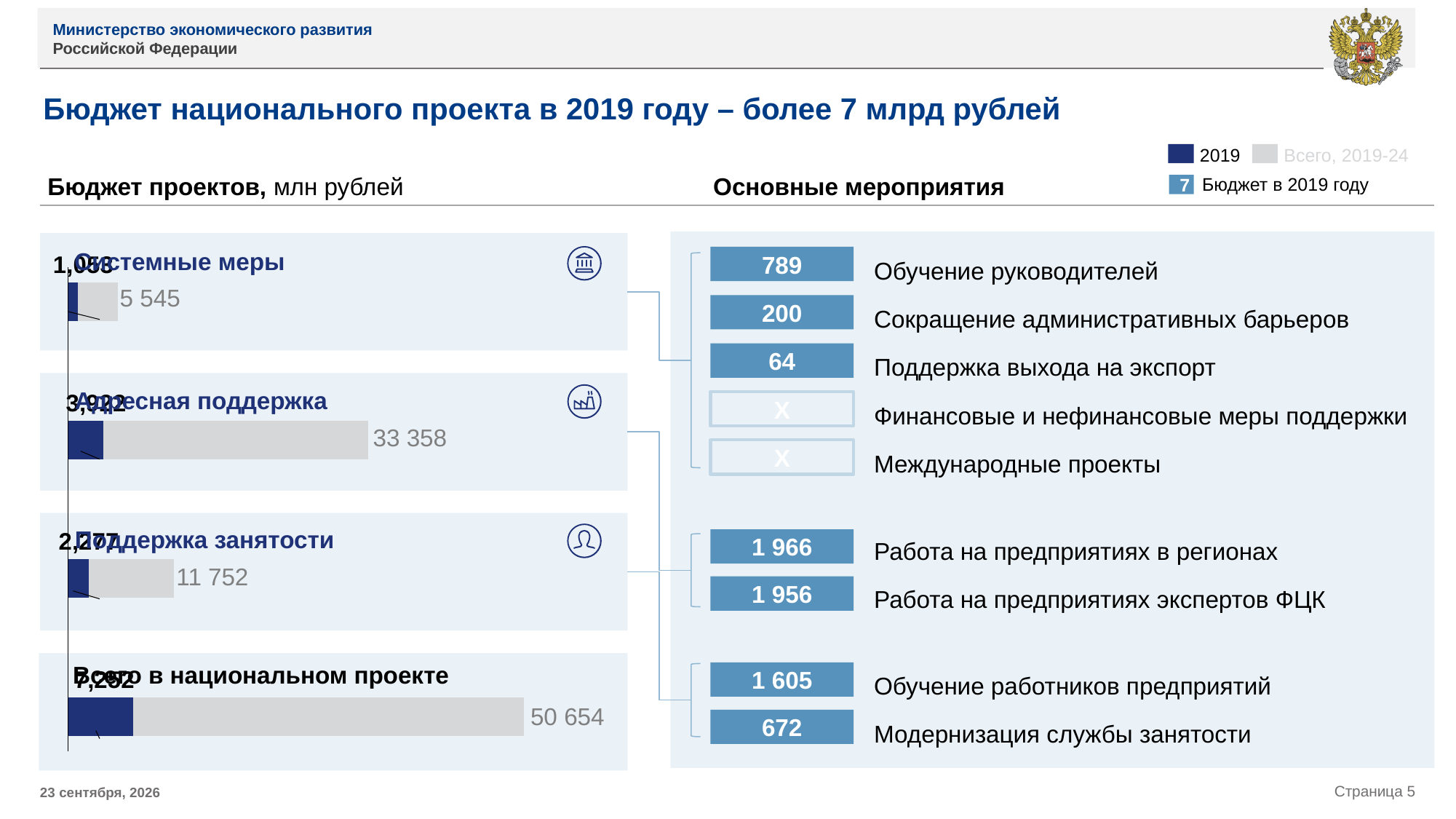
What is the value of 'Всего, 2019-24' for 'Адресная поддержка' in the 'Бюджет проектов' chart? 33 358 What kind of chart is the 'Бюджет проектов' chart? bar chart What is the value of 'Всего, 2019-24' for 'Поддержка занятости' in the 'Бюджет проектов' chart? 11 752 Among 'Системные меры', 'Адресная поддержка' and 'Поддержка занятости', which has the highest 'Всего, 2019-24' value? Адресная поддержка Among 'Системные меры', 'Адресная поддержка' and 'Поддержка занятости', which has the lowest 'Всего, 2019-24' value? Системные меры In what unit are the values of the 'Бюджет проектов' chart given? млн рублей What is the value of 'Всего, 2019-24' for 'Системные меры' in the 'Бюджет проектов' chart? 5 545 Which is larger for 'Всего, 2019-24': 'Адресная поддержка' or 'Поддержка занятости'? Адресная поддержка What is the difference between the 'Всего, 2019-24' values for 'Адресная поддержка' and 'Поддержка занятости'? 21 606 How many series does the legend of the 'Бюджет проектов' chart list? 2 What is the value of 'Всего, 2019-24' for 'Всего в национальном проекте' in the 'Бюджет проектов' chart? 50 654 What is the difference between the 'Всего, 2019-24' values for 'Поддержка занятости' and 'Системные меры'? 6 207